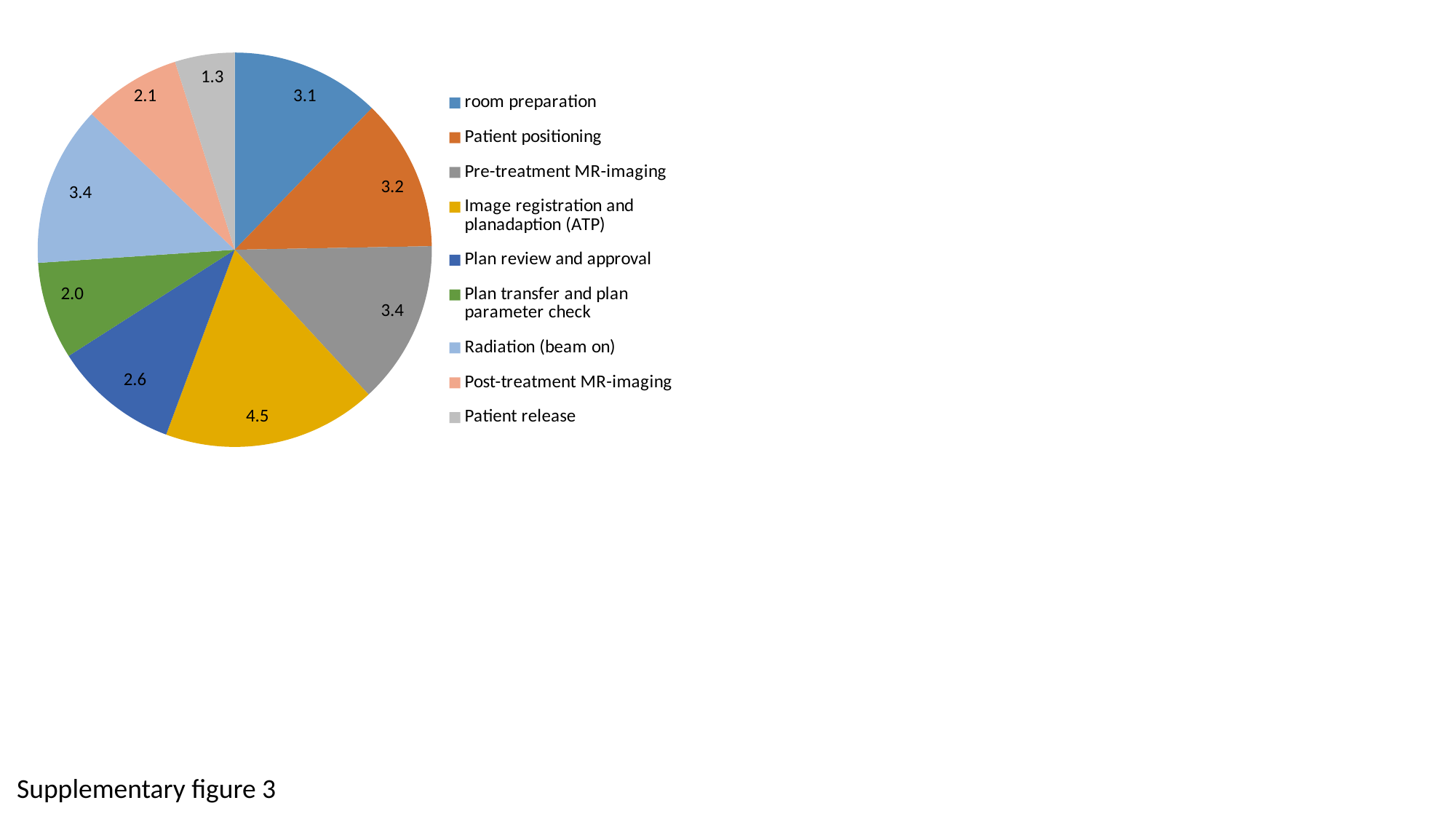
What colour is the Radiation (beam on) slice in the pie chart? Light blue What is the value shown for the Patient release slice? 1.3 What is the value shown for the Image registration and planadaption (ATP) slice? 4.5 What kind of chart is shown on the slide? Pie chart Which category has the largest slice in the pie chart? Image registration and planadaption (ATP) What is the value shown for the Post-treatment MR-imaging slice? 2.1 Which is larger, the value for Plan review and approval or the value for Plan transfer and plan parameter check? Plan review and approval What is the value shown for the Plan review and approval slice? 2.6 What is the difference between the values for Image registration and planadaption (ATP) and Patient release? 3.2 What is the difference between the values for room preparation and Plan transfer and plan parameter check? 1.1 Which category has the smallest slice in the pie chart? Patient release How many slices does the pie chart have? 9